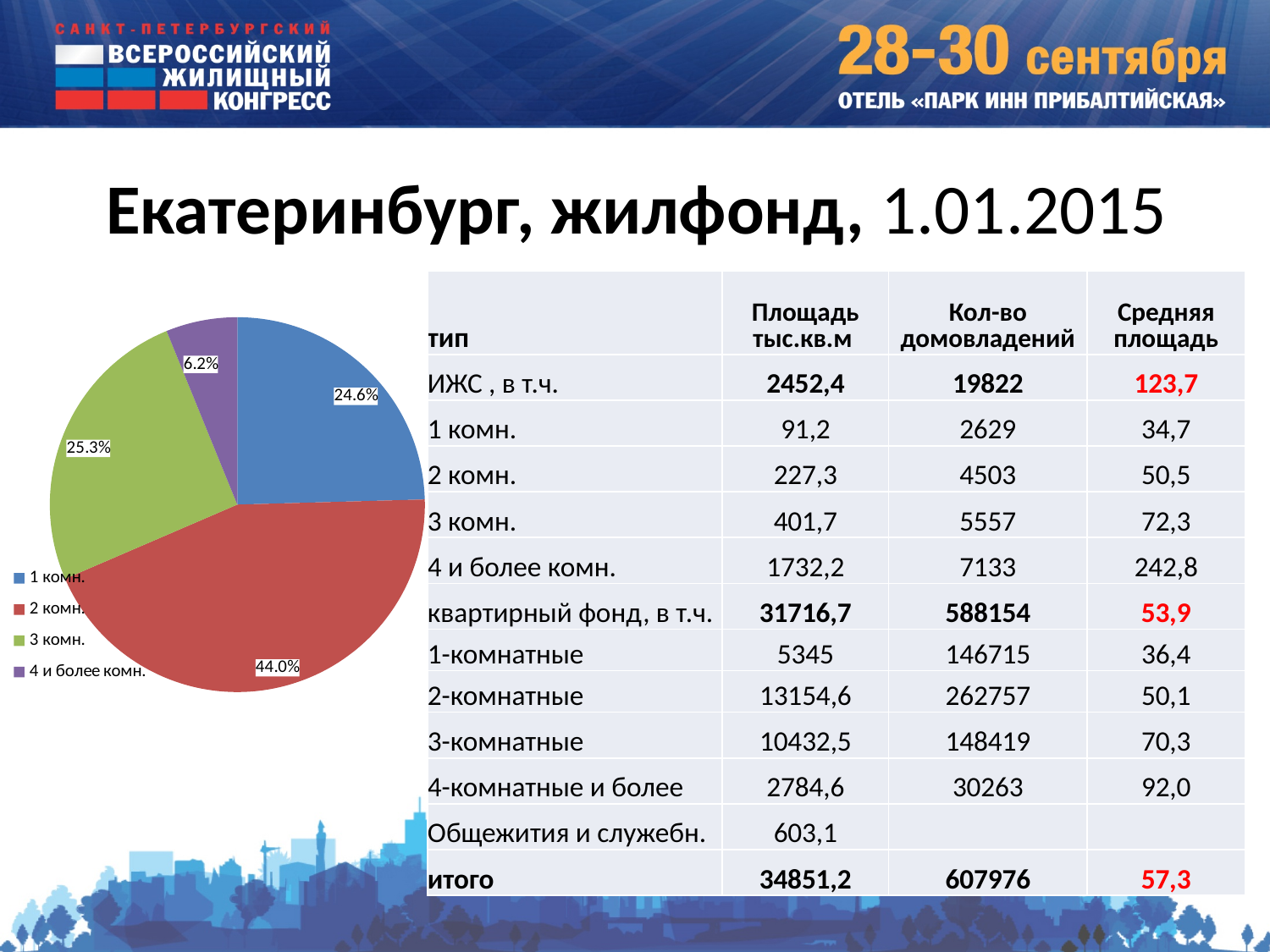
What share of the pie chart does the "2 комн." slice represent? 44.0% Which category has the smallest slice in the pie chart? 4 и более комн. What is the difference in percentage points between the "2 комн." slice and the "3 комн." slice in the pie chart? 18.7 What share of the pie chart does the "3 комн." slice represent? 25.3% Which category has the largest slice in the pie chart? 2 комн. In the pie chart, which slice is larger: "1 комн." or "4 и более комн."? 1 комн. What colour is the "3 комн." slice in the pie chart? green How many slices does the pie chart have? 4 What share of the pie chart does the "1 комн." slice represent? 24.6% What kind of chart is shown on the slide? pie chart How many entries does the pie chart's legend list? 4